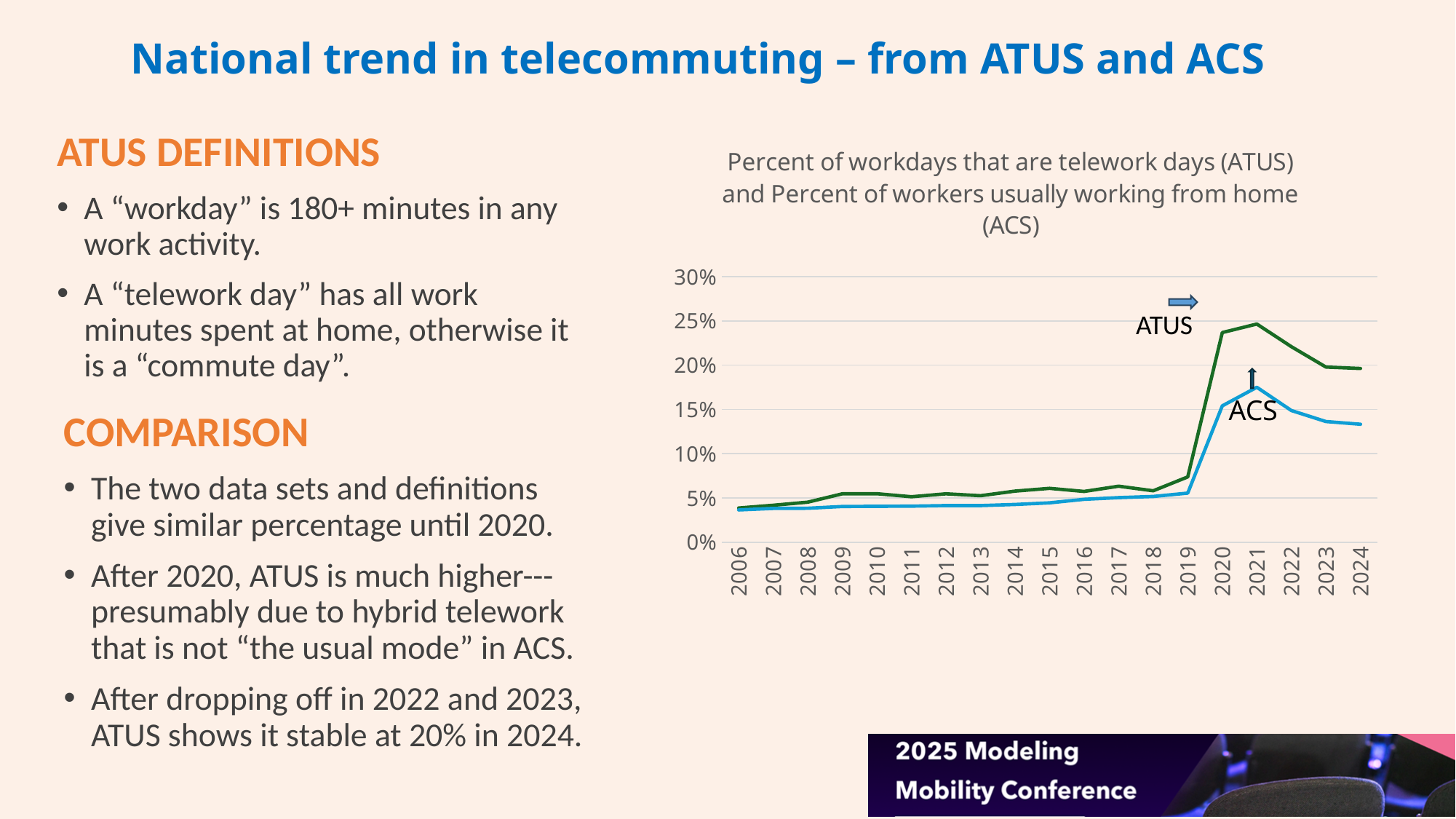
Is the ACS value for 2019 greater or less than 10%? less What colour is the ATUS line on the chart? green Is the ACS value for 2024 greater or less than 15%? less In 2022, which series has the higher value, ATUS or ACS? ATUS What kind of chart is shown on the slide? line chart In which year does the ACS line reach its highest value? 2021 Is the ATUS value for 2006 greater or less than 5%? less How many data series (lines) are plotted on the chart? 2 In which year does the ATUS line reach its highest value? 2021 Between 2021 and 2024, does the ATUS line rise or fall? fall How many years are plotted along the x axis of the chart? 19